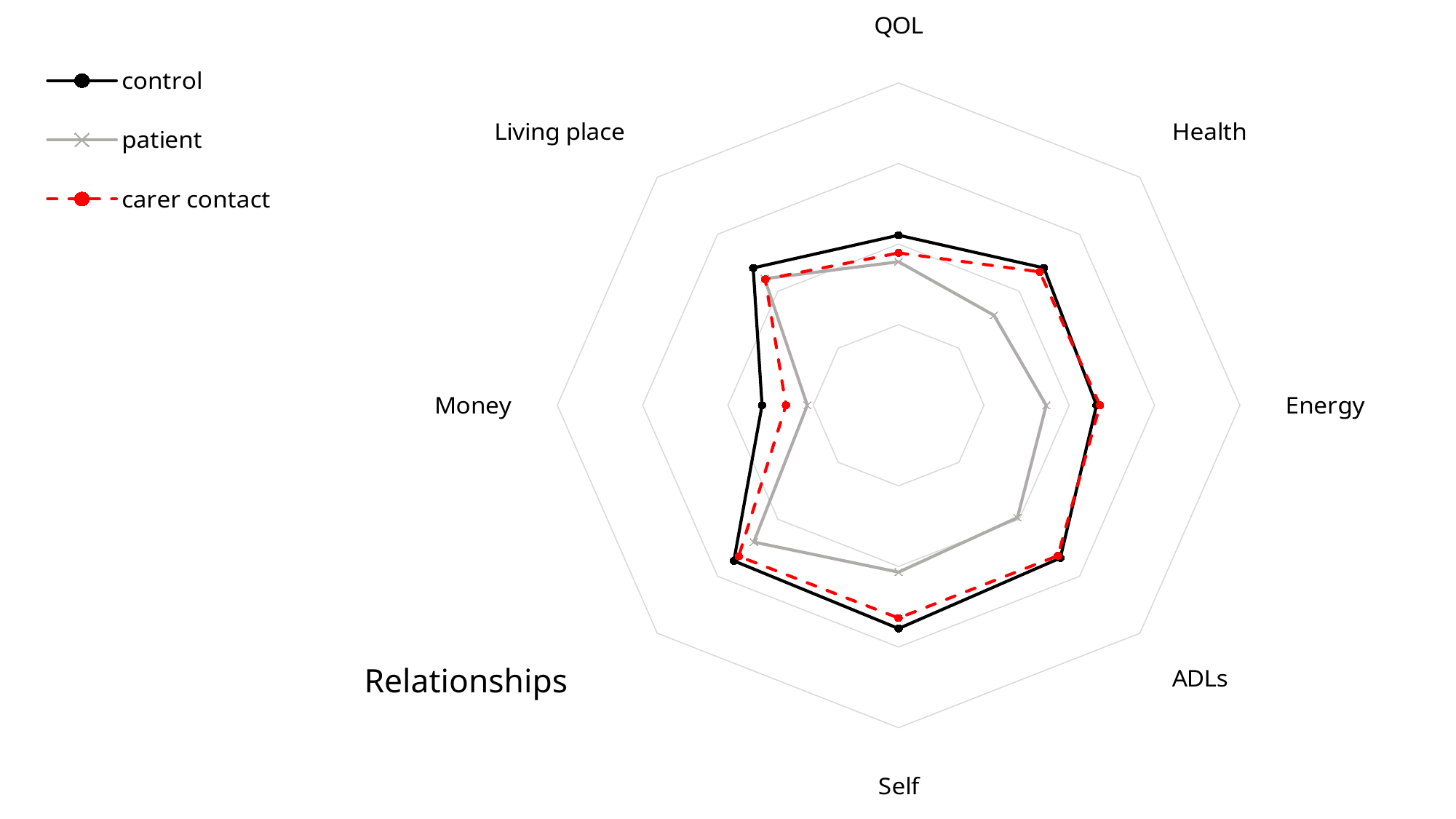
At the Self category, which series has the larger value: control or patient? control How many categories (axes) does the radar chart have? 8 For the control series, which category has the lowest value? Money Which series is drawn with grey x markers? patient At the Health category, which series has the larger value: patient or control? control How many series does the legend list? 3 For the patient series, which category has the lowest value? Money For the control series, which category has the highest value? Self At the Money category, which series has the lowest value? patient What kind of chart is shown on the slide? radar chart Which series is drawn with a red dashed line? carer contact